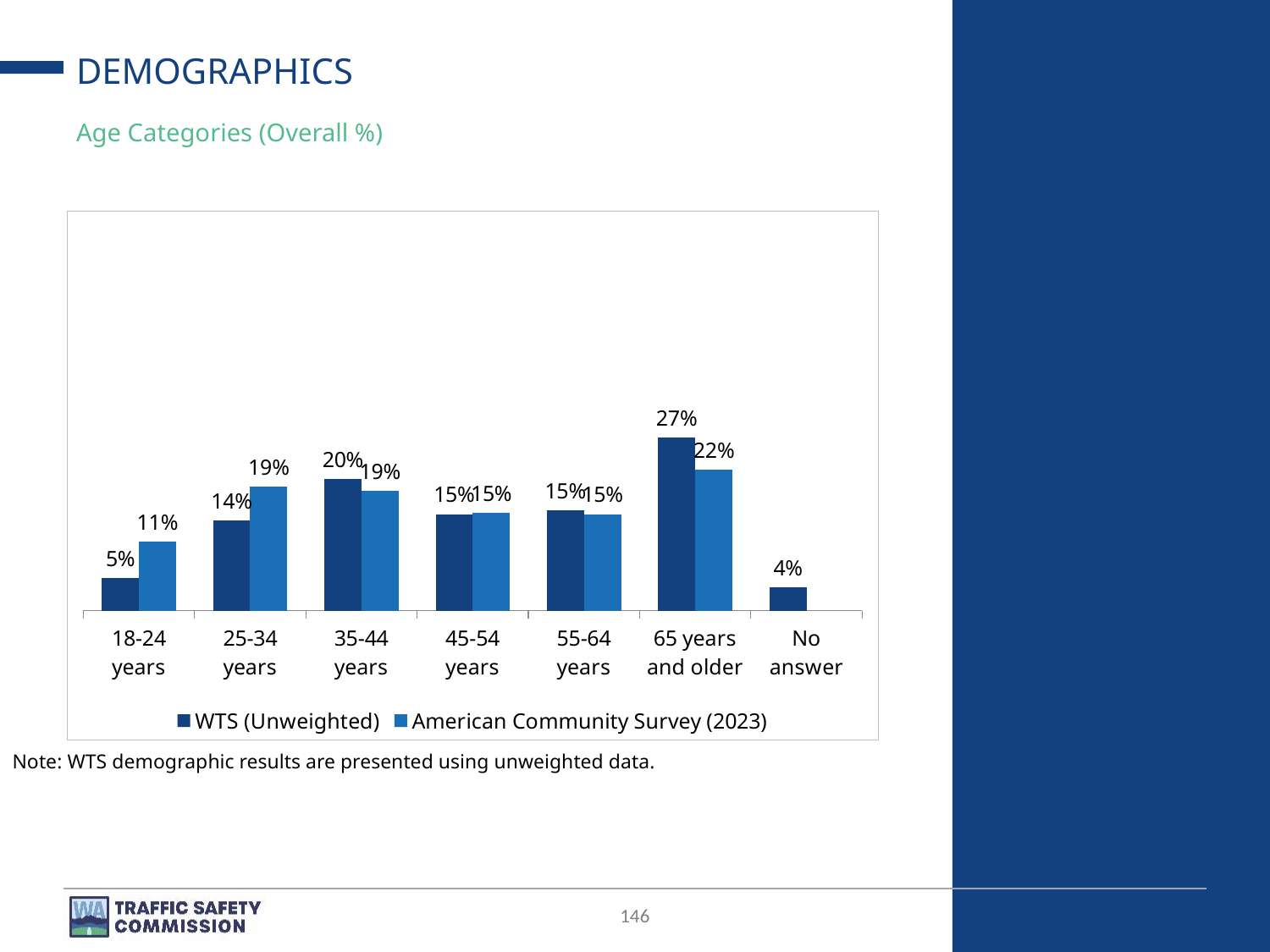
For 35-44 years, which series has the larger value, WTS (Unweighted) or American Community Survey (2023)? WTS (Unweighted) How many age categories are shown on the x axis? 7 Which age category has the highest WTS (Unweighted) value? 65 years and older What is the WTS (Unweighted) value for 65 years and older? 27% What is the difference between the WTS (Unweighted) and American Community Survey (2023) values for 18-24 years? 6% What is the WTS (Unweighted) value for 18-24 years? 5% What kind of chart is shown on the slide? Bar chart What is the American Community Survey (2023) value for 25-34 years? 19% What is the subtitle of the chart? Age Categories (Overall %) How many series does the legend list? 2 What is the WTS (Unweighted) value for No answer? 4% Which category has the lowest WTS (Unweighted) value? No answer